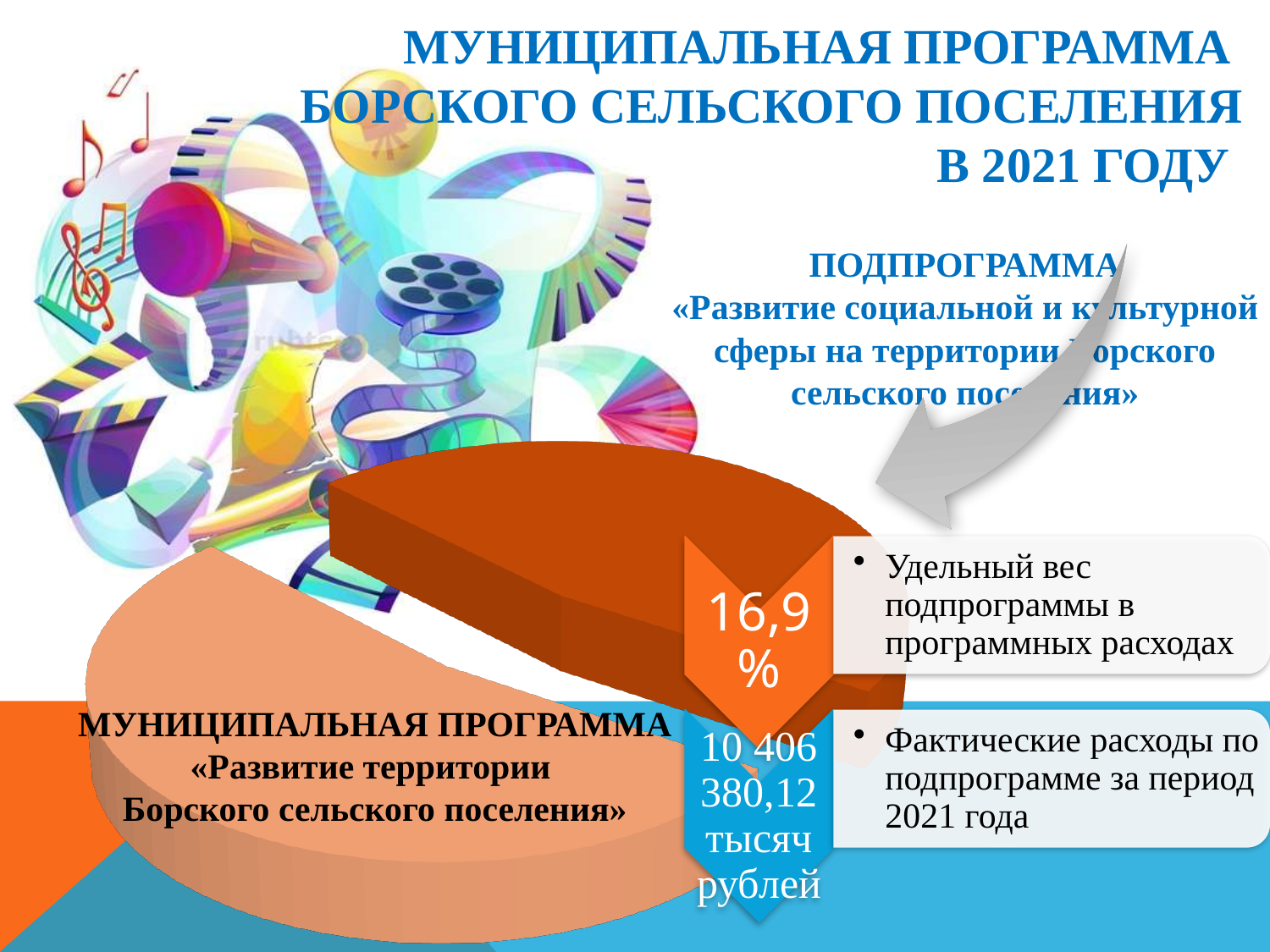
What kind of chart is shown on the slide? pie chart What share of the programme expenses does the subprogramme «Развитие социальной и культурной сферы на территории Борского сельского поселения» account for? 16,9% Is the subprogramme's share of programme expenses greater or less than 50%? less Which year do the expenses shown on the slide refer to? 2021 What were the actual expenses for the subprogramme in 2021, as printed on the slide? 10 406 380,12 тысяч рублей How many slices does the pie chart have? 2